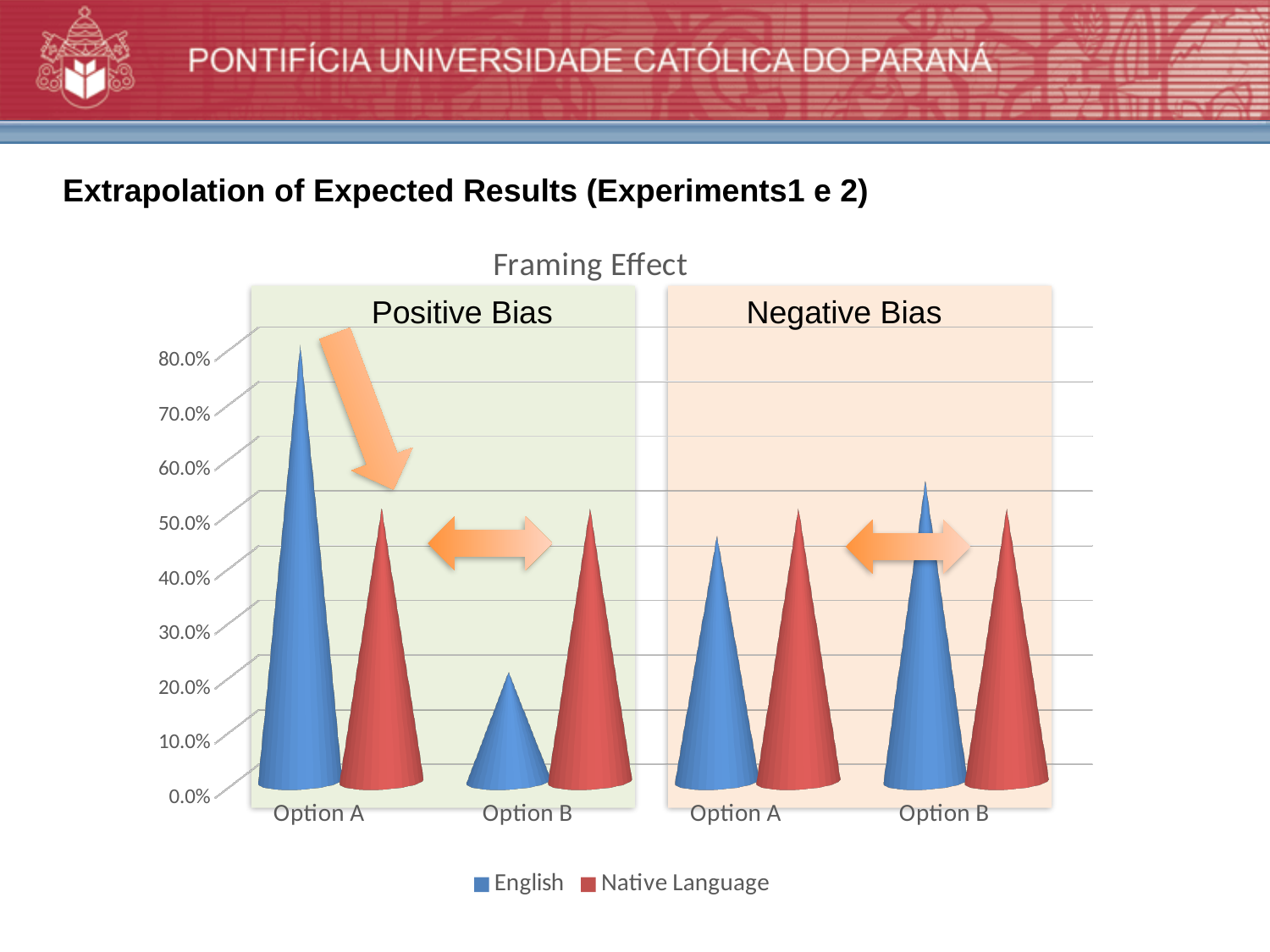
What are the two series named in the legend? English and Native Language How many category positions are shown along the x axis? 4 Under Positive Bias, is the English value for Option A greater or less than 70.0%? greater What is the title of the chart? Framing Effect Under Positive Bias, is the English value for Option B greater or less than 30.0%? less Does the English series rise or fall from Option A to Option B under Positive Bias? fall Under Positive Bias, which is larger for Option B: English or Native Language? Native Language Under Positive Bias, which is larger for Option A: English or Native Language? English Under Negative Bias, is the English value for Option A greater or less than 60.0%? less How many series does the chart legend list? 2 Which bar is the shortest in the chart? English for Option B under Positive Bias Which bar is the tallest in the chart? English for Option A under Positive Bias